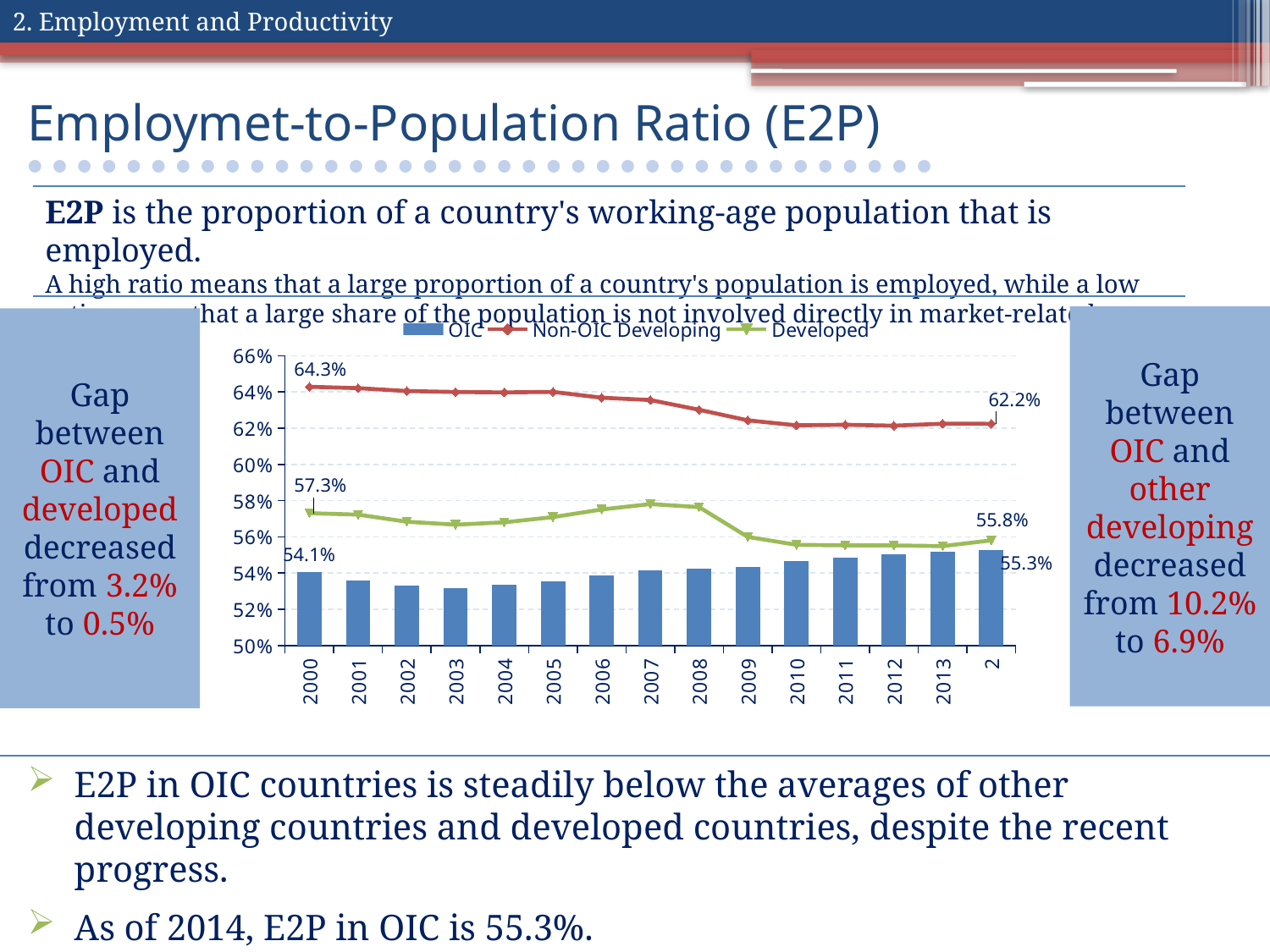
What kind of chart is shown on the slide? combined bar and line chart By how much did the Non-OIC Developing ratio fall from 2000 (64.3%) to 2014 (62.2%)? 2.1% Does the Non-OIC Developing line rise or fall from 2000 to 2014? fall Which series has the highest value in 2014? Non-OIC Developing What is the OIC value shown for 2014? 55.3% What is the OIC employment-to-population ratio shown for 2000? 54.1% In 2000, which was higher: Non-OIC Developing or Developed? Non-OIC Developing What is the Non-OIC Developing value shown for 2000? 64.3% What is the Developed value shown at the end of the series in 2014? 55.8% By how much did the OIC ratio rise from 2000 (54.1%) to 2014 (55.3%)? 1.2% Is the Non-OIC Developing value for 2010 greater or less than 64%? less How many series does the legend list? 3